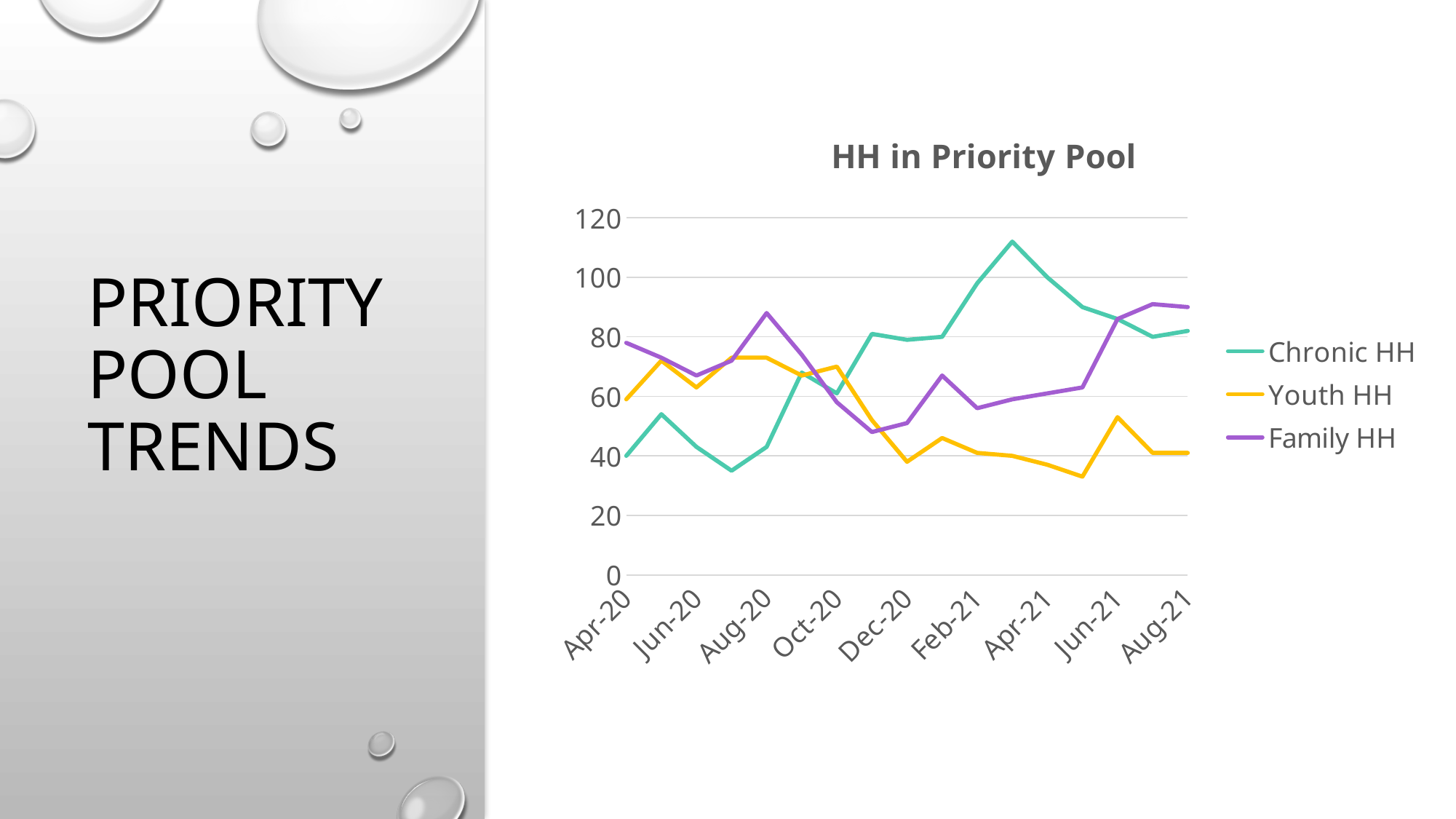
What is the title of the chart? HH in Priority Pool Which series reaches the highest value anywhere on the chart? Chronic HH Is the value for Family HH at Aug-20 greater or less than 80? greater Is the value for Family HH at Dec-20 greater or less than 60? less How many month labels are shown on the x axis of the chart? 9 Which series is shown in purple in the chart? Family HH Is the value for Youth HH at Jun-21 greater or less than 40? greater How many series does the legend of the chart list? 3 Does the Family HH line rise or fall overall from Dec-20 to Aug-21? rise What kind of chart is shown on the slide? line chart At Aug-21, which is larger: Family HH or Chronic HH? Family HH Which series has the lowest value at Jun-21? Youth HH